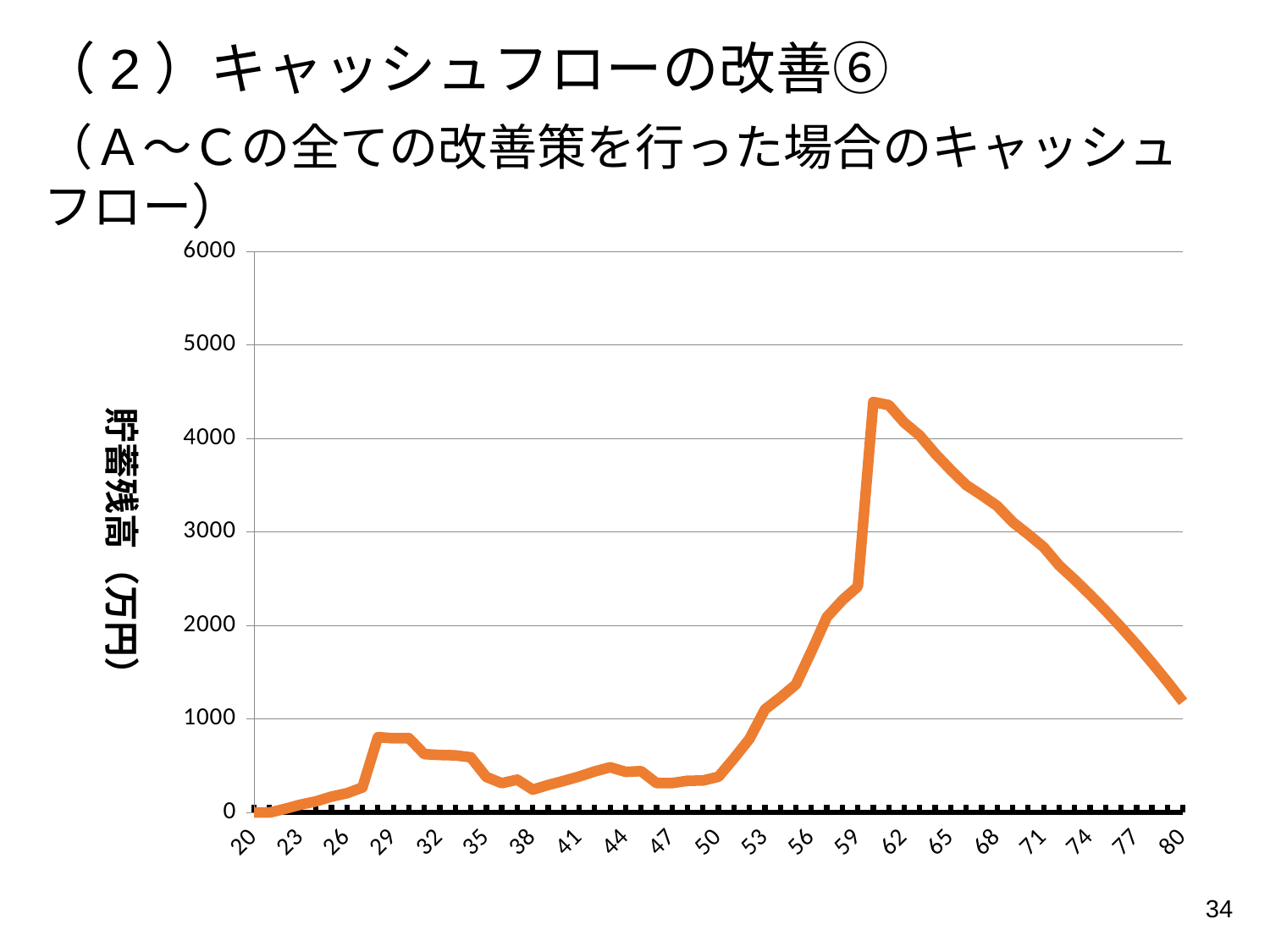
Which is larger, the value at age 62 or the value at age 80? age 62 Is the value at age 50 greater or less than 1000? less Do the values rise or fall from age 62 to age 80? fall How many tick labels are shown along the horizontal axis of the chart? 21 What is the highest value shown on the vertical axis of the chart? 6000 Is the value at age 80 greater or less than 1000? greater Is the value at age 71 greater or less than 3000? less What is the label on the vertical axis of the chart? 貯蓄残高（万円） Which is larger, the value at age 29 or the value at age 47? age 29 What kind of chart is shown on the slide? line chart